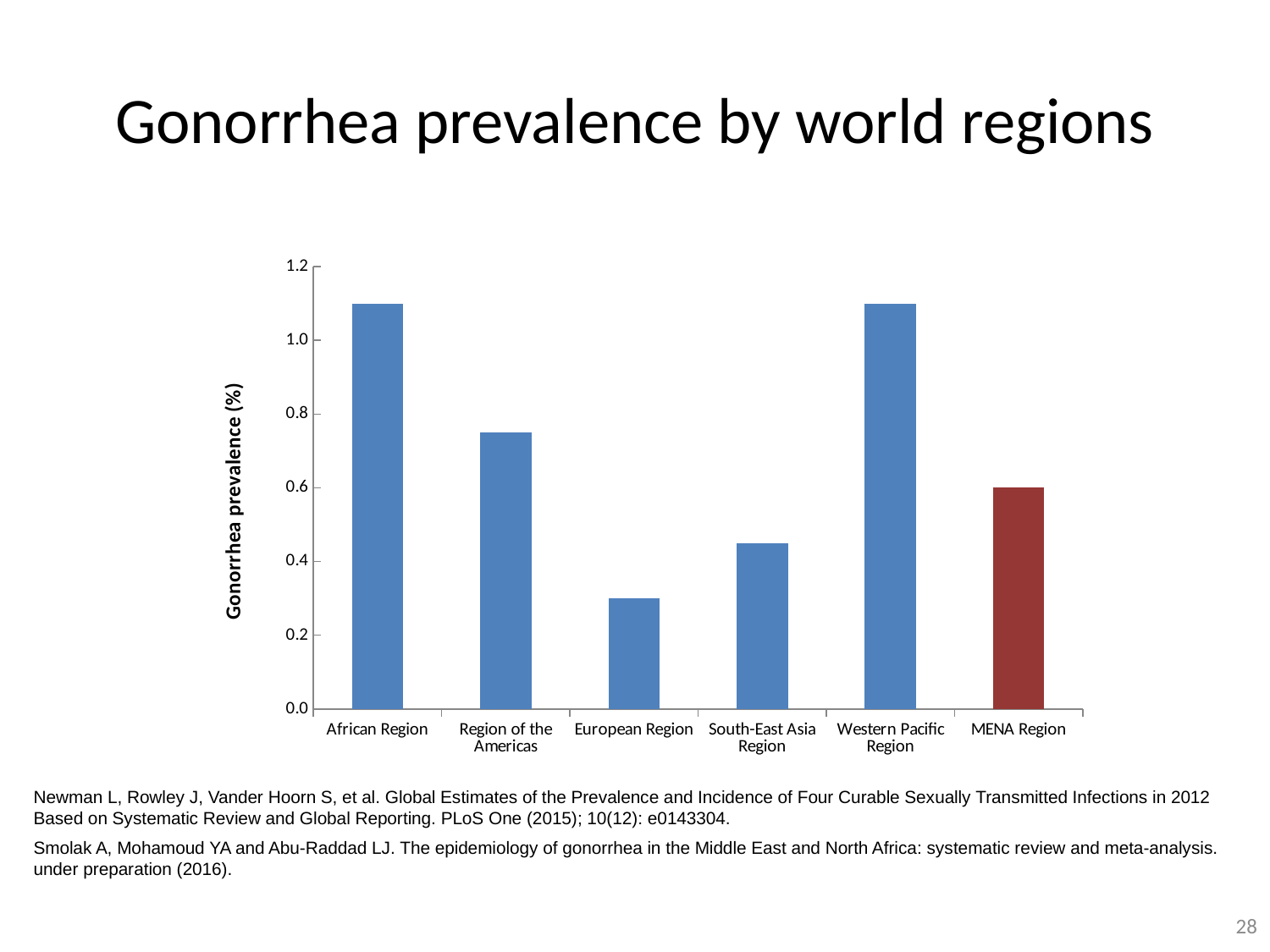
What is the label of the vertical axis of the chart? Gonorrhea prevalence (%) Which region has the lowest gonorrhea prevalence in the chart? European Region How many world regions are shown on the x axis of the chart? 6 What kind of chart is shown on the slide? bar chart Is the gonorrhea prevalence for the African Region greater or less than 1.0? greater Is the gonorrhea prevalence for the South-East Asia Region greater or less than 0.4? greater Is the gonorrhea prevalence for the Western Pacific Region greater or less than 1.0? greater Which has a higher gonorrhea prevalence, the Region of the Americas or the South-East Asia Region? Region of the Americas Which has a higher gonorrhea prevalence, the MENA Region or the European Region? MENA Region Which region's bar is coloured differently (red) from the other bars? MENA Region